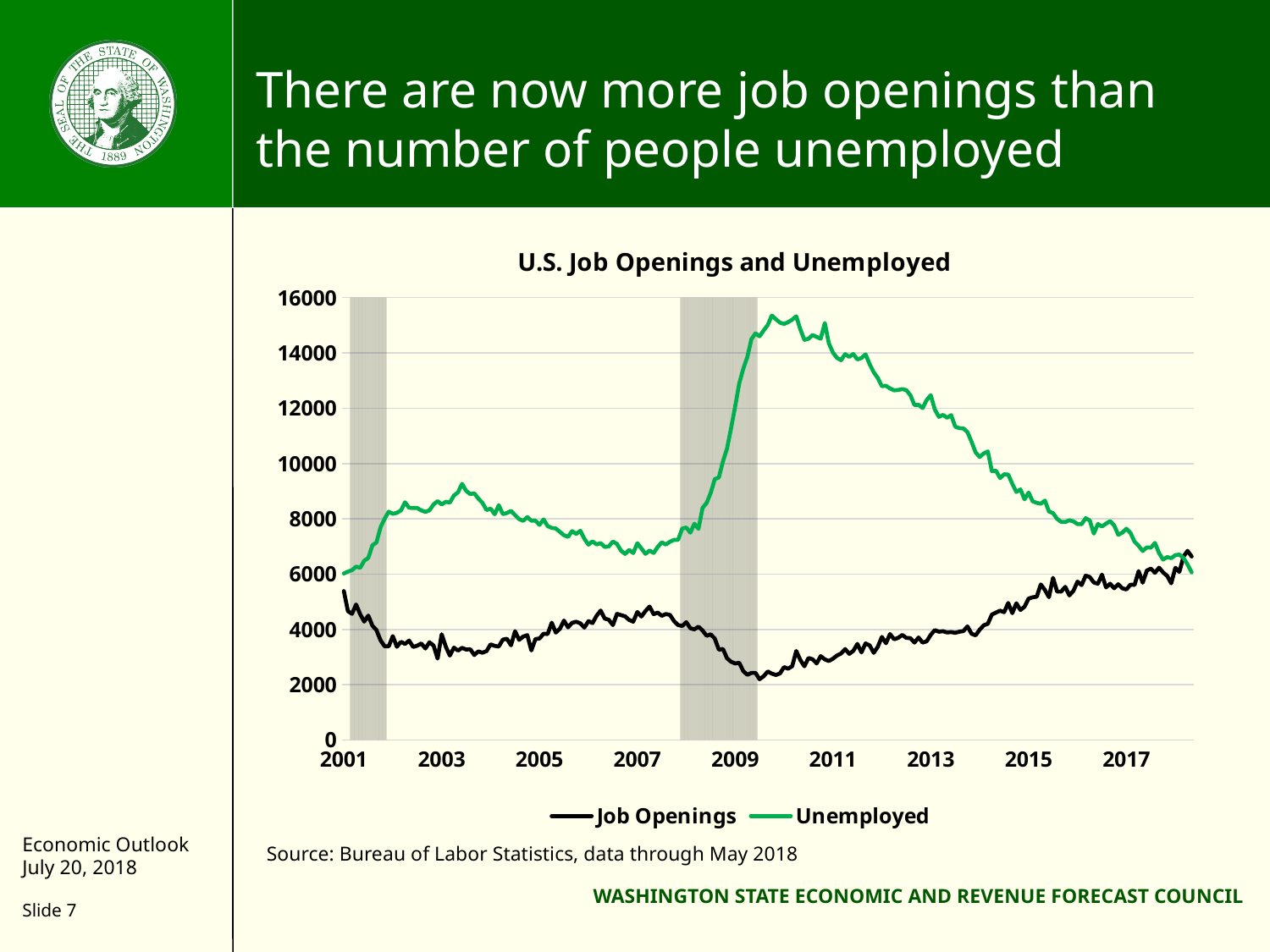
Is the value of Job Openings at its low point around 2009 greater or less than 4000? less In 2011, which series has the higher value, Job Openings or Unemployed? Unemployed What is the title of the chart? U.S. Job Openings and Unemployed Is the value of Job Openings in 2005 greater or less than 6000? less Does the Unemployed series rise or fall between 2010 and 2017? fall Is the value of the Unemployed series at the start of 2013 greater or less than 10000? greater What kind of chart is shown on the slide? line chart Which colour is used for the Unemployed series? green How many series does the legend list? 2 Does the Job Openings series rise or fall between 2009 and 2017? rise